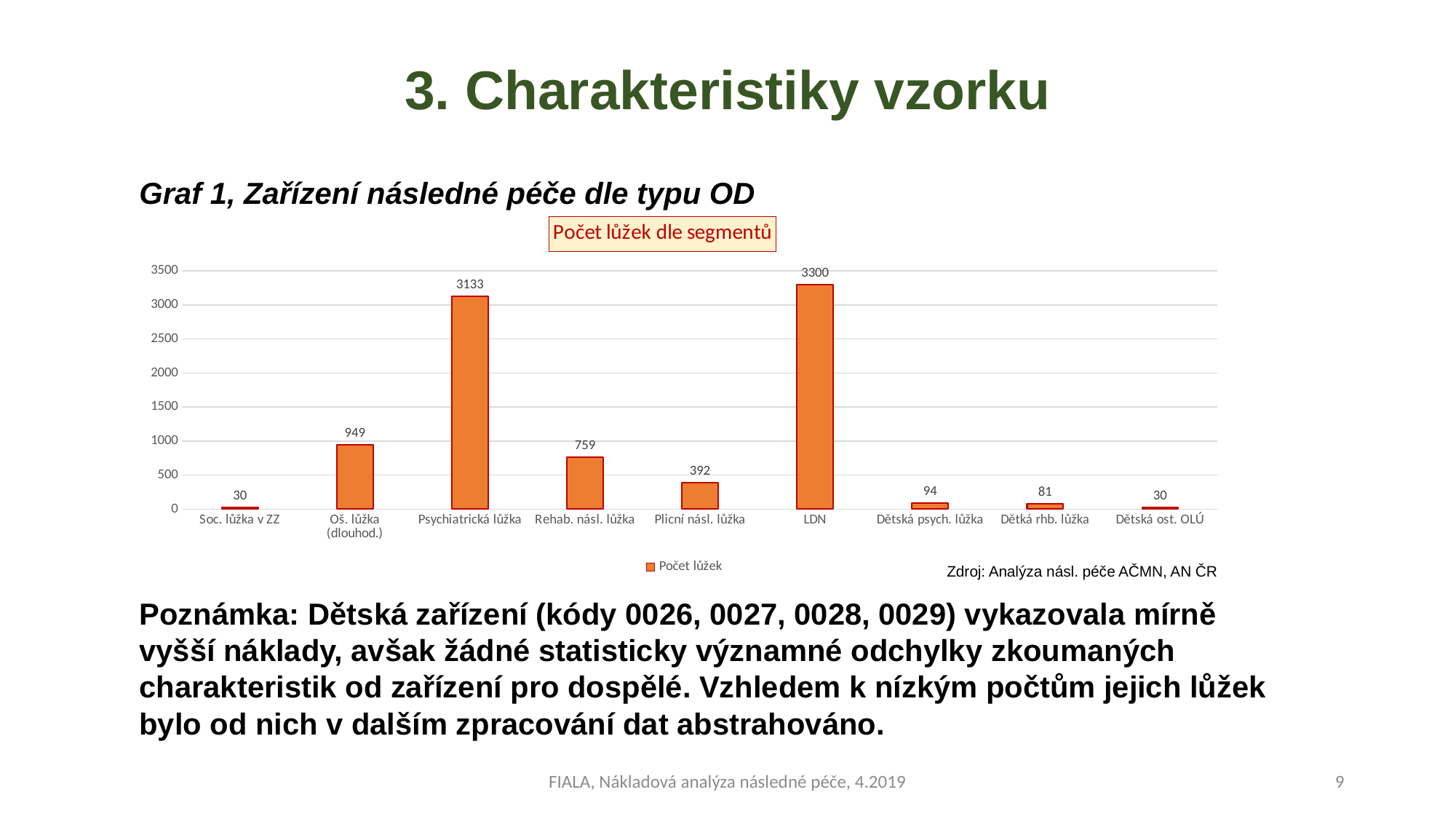
What is the value for Plicní násl. lůžka? 392 What is the value for LDN in the chart? 3300 Which is larger, the value for Rehab. násl. lůžka or the value for Plicní násl. lůžka? Rehab. násl. lůžka What is the title of the chart? Počet lůžek dle segmentů Which category has the highest value? LDN What is the value for Psychiatrická lůžka? 3133 What is the difference between the values for LDN and Psychiatrická lůžka? 167 Is the value for Oš. lůžka (dlouhod.) greater or less than 500? greater What kind of chart is shown? bar chart How many categories are shown on the x axis? 9 How many series does the legend list? 1 What is the value for Oš. lůžka (dlouhod.)? 949